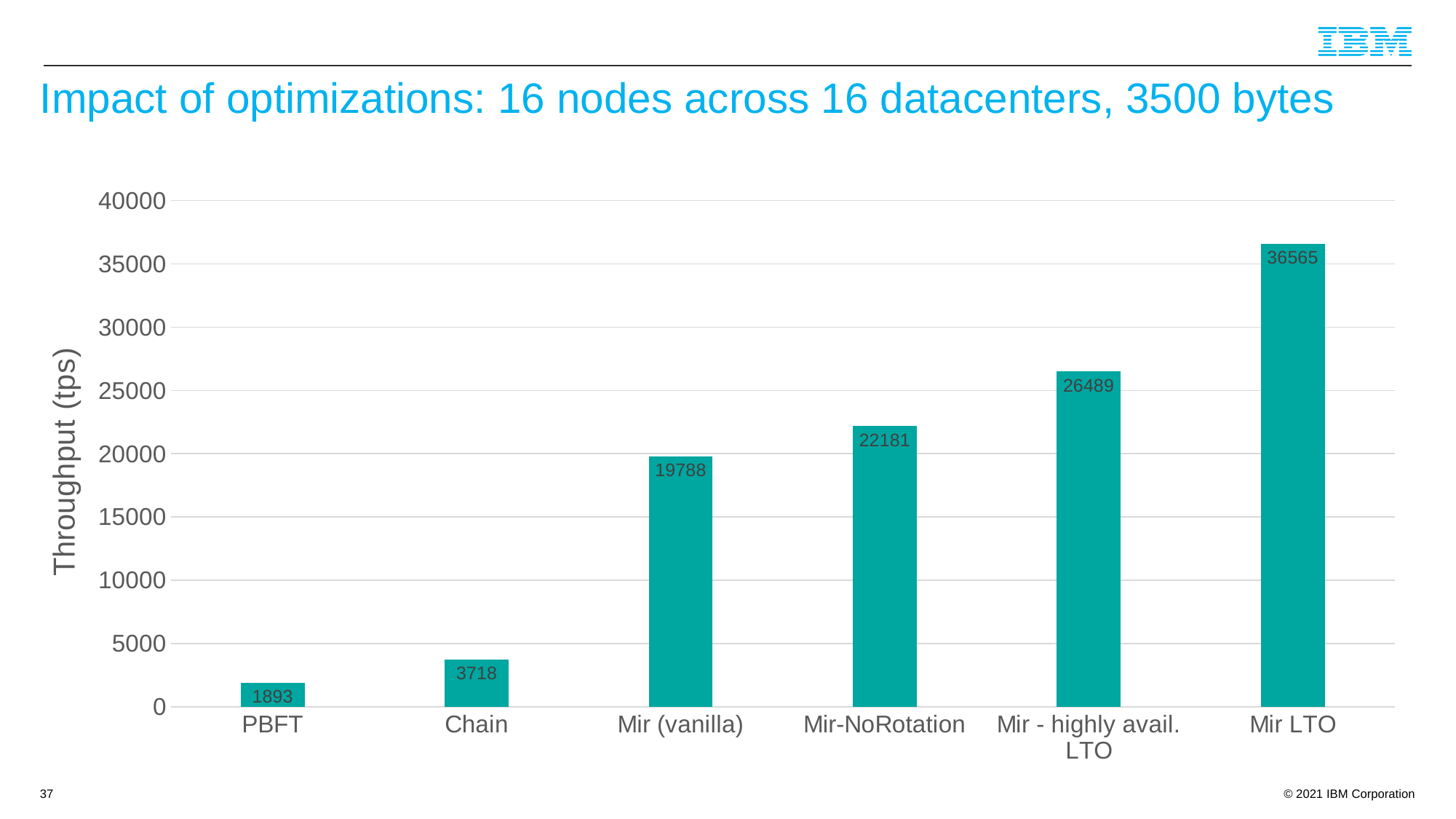
How many categories are shown on the x axis? 6 What kind of chart is shown on the slide? Bar chart What is the throughput for PBFT? 1893 What is the throughput for Mir - highly avail. LTO? 26489 What is the difference in throughput between Mir LTO and Mir (vanilla)? 16777 Is the throughput for Mir - highly avail. LTO greater or less than 25000? greater Which category has the lowest throughput? PBFT What is the throughput for Mir-NoRotation? 22181 What is the throughput for Mir LTO? 36565 Which category has the highest throughput? Mir LTO Which has higher throughput, Mir-NoRotation or Mir (vanilla)? Mir-NoRotation What is the difference in throughput between Chain and PBFT? 1825